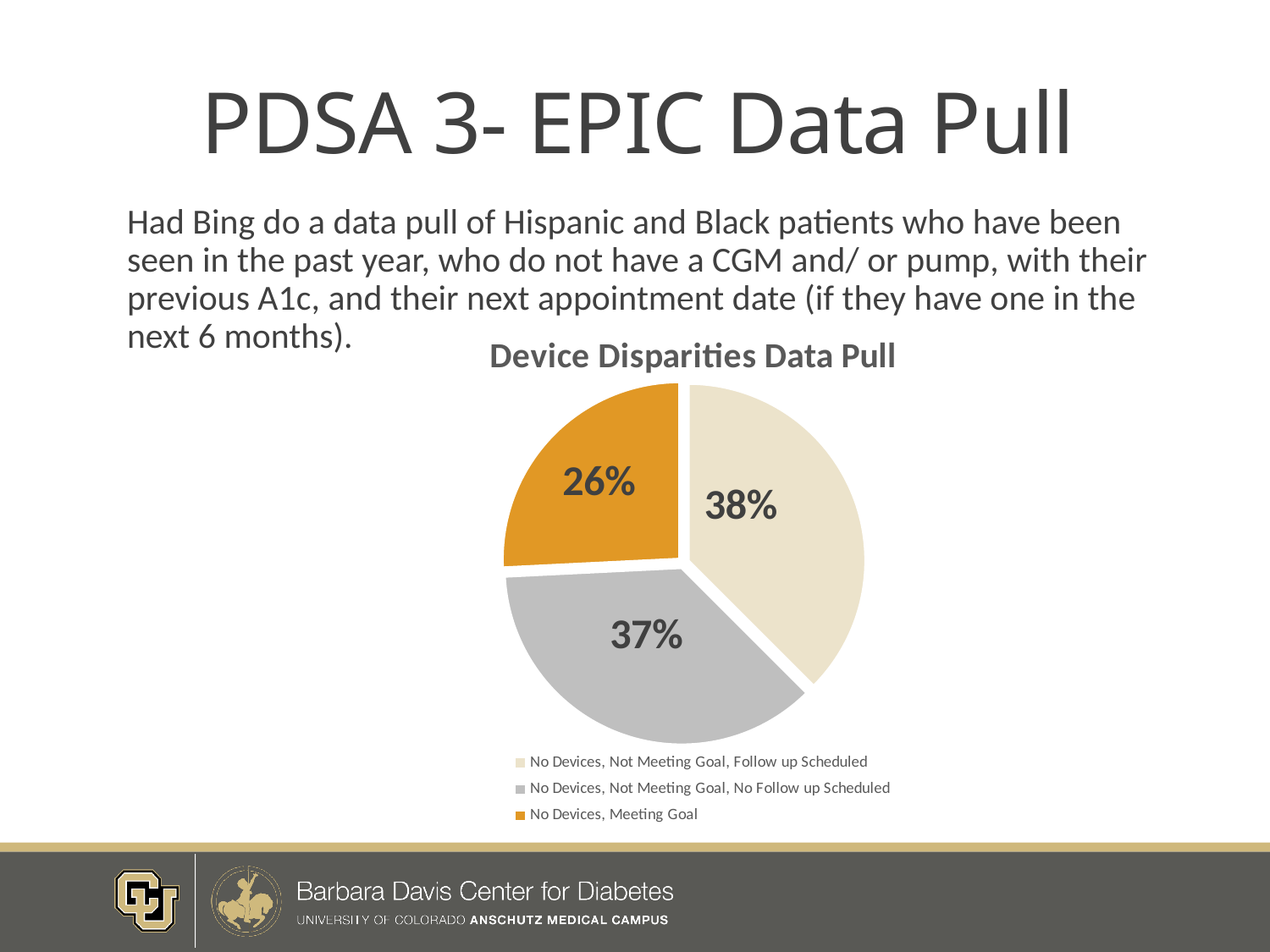
Which category has the smallest slice of the pie? No Devices, Meeting Goal What share of the pie is "No Devices, Meeting Goal"? 26% What share of the pie is "No Devices, Not Meeting Goal, No Follow up Scheduled"? 37% What colour is the slice for "No Devices, Meeting Goal"? orange What is the difference in percentage points between "No Devices, Not Meeting Goal, No Follow up Scheduled" and "No Devices, Meeting Goal"? 11 What share of the pie is "No Devices, Not Meeting Goal, Follow up Scheduled"? 38% Which category has the largest slice of the pie? No Devices, Not Meeting Goal, Follow up Scheduled How many slices does the pie chart have? 3 What is the difference in percentage points between "No Devices, Not Meeting Goal, Follow up Scheduled" and "No Devices, Meeting Goal"? 12 What is the title of the chart? Device Disparities Data Pull What kind of chart is shown on the slide? pie chart Which is larger: the slice for "No Devices, Not Meeting Goal, No Follow up Scheduled" or the slice for "No Devices, Meeting Goal"? No Devices, Not Meeting Goal, No Follow up Scheduled